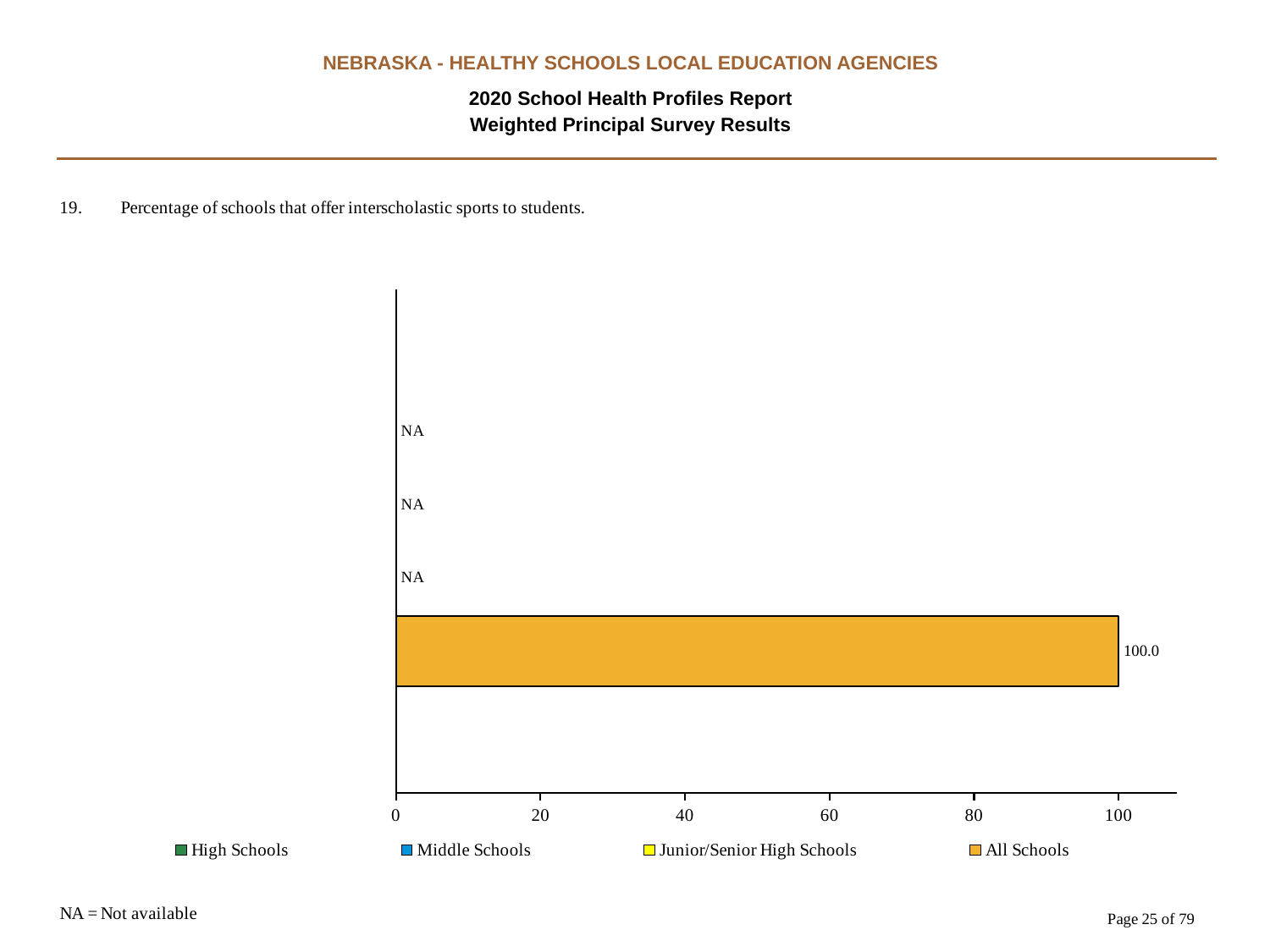
Which series has the highest plotted value? All Schools What value is shown for Middle Schools? NA What kind of chart is shown on the slide? Bar chart What is the highest value shown on the x axis? 100 How many series does the legend list? 4 What is the value for All Schools? 100.0 How many series are marked NA on the chart? 3 What value is shown for Junior/Senior High Schools? NA What value is shown for High Schools? NA Is the value for All Schools greater or less than 80? greater What does NA stand for according to the note on the slide? Not available